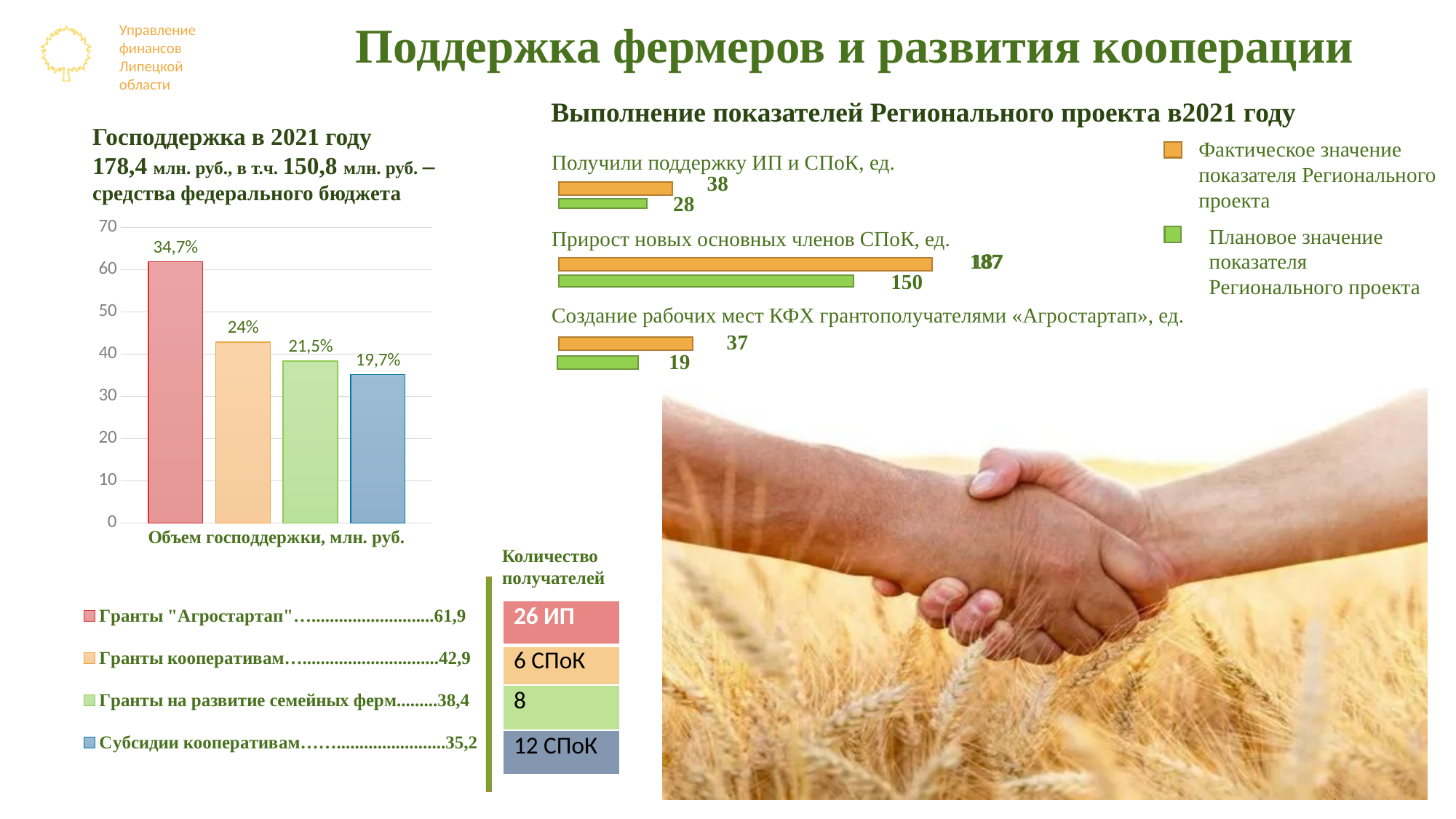
In the left bar chart (Объем господдержки, млн. руб.), is the bar for Гранты кооперативам greater or less than 40? greater In the left bar chart (Объем господдержки, млн. руб.), how many bars are plotted? 4 In the right chart (Выполнение показателей Регионального проекта в 2021 году), how many series does the legend list? 2 In the left bar chart (Объем господдержки, млн. руб.), which category has the lowest bar? Субсидии кооперативам In the right chart (Выполнение показателей Регионального проекта в 2021 году), by how much does the actual value exceed the planned value for Получили поддержку ИП и СПоК, ед.? 10 In the right chart (Выполнение показателей Регионального проекта в 2021 году), which colour represents the planned value (Плановое значение показателя Регионального проекта)? Green In the left bar chart (Объем господдержки, млн. руб.), what is the difference between the legend values for Гранты "Агростартап" and Гранты кооперативам? 19 In the left bar chart (Объем господдержки, млн. руб.), which category has the highest bar? Гранты "Агростартап" In the right chart (Выполнение показателей Регионального проекта в 2021 году), what is the actual value (Фактическое значение) for Прирост новых основных членов СПоК, ед.? 187 In the left bar chart (Объем господдержки, млн. руб.), what percentage is shown above the bar for Гранты "Агростартап"? 34,7% In the right chart (Выполнение показателей Регионального проекта в 2021 году), what is the planned value (Плановое значение) for Создание рабочих мест КФХ грантополучателями «Агростартап», ед.? 19 In the left bar chart (Объем господдержки, млн. руб.), what value does the legend give for Субсидии кооперативам? 35,2